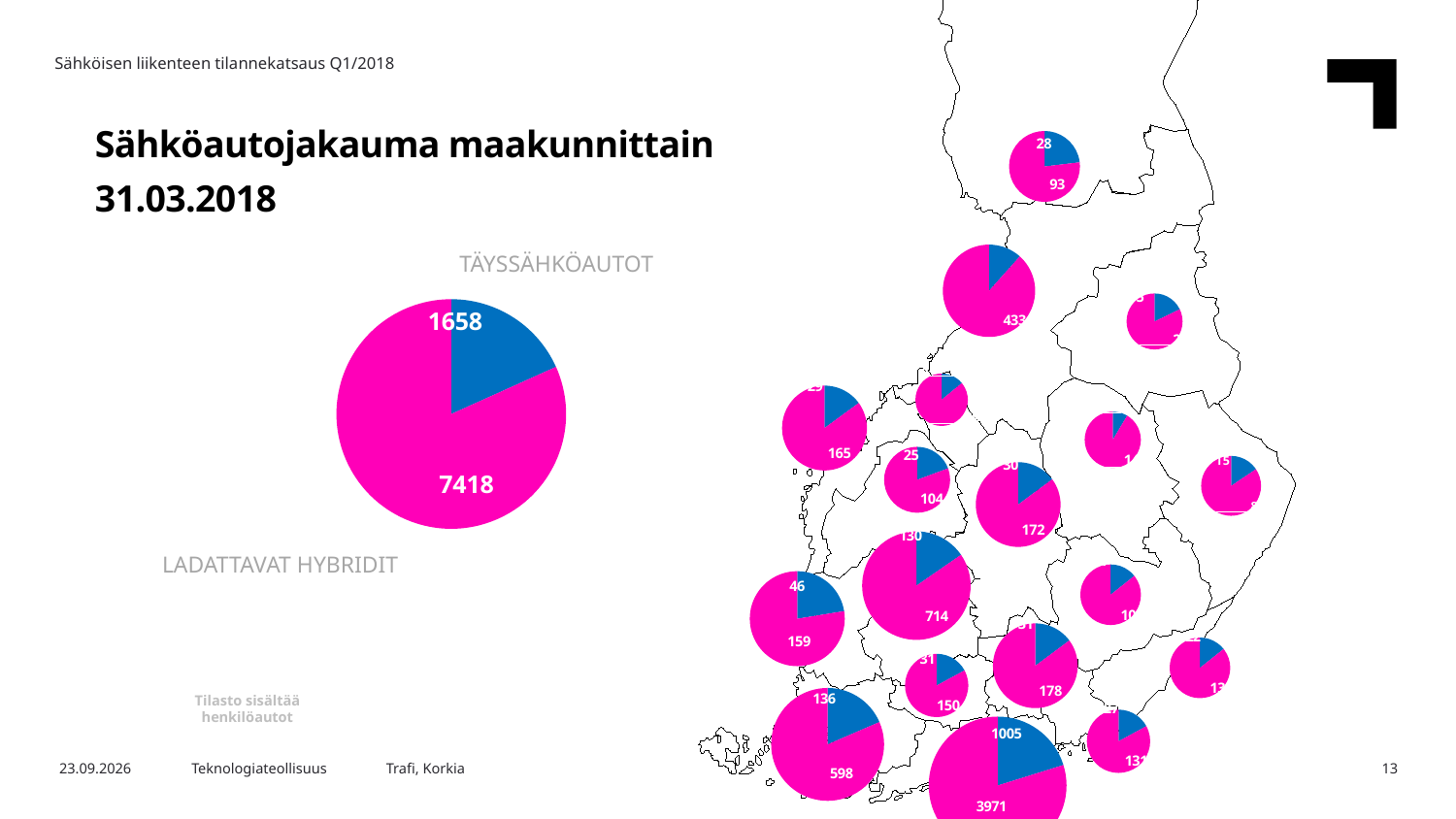
How many slices does the large pie chart on the left have? 2 In the large pie chart on the left, what is the value for TÄYSSÄHKÖAUTOT? 1658 In the large pie chart on the left, what is the value for LADATTAVAT HYBRIDIT? 7418 In the large pie chart on the left, what colour is the TÄYSSÄHKÖAUTOT slice? Blue On the map on the right, what are the two values shown in the largest pie (at the bottom)? 1005 and 3971 In the large pie chart on the left, is the value for TÄYSSÄHKÖAUTOT greater or less than 2000? less What is the title of the slide containing the pie charts? Sähköautojakauma maakunnittain 31.03.2018 In the large pie chart on the left, which category has the larger value? LADATTAVAT HYBRIDIT In the large pie chart on the left, which category has the smaller value? TÄYSSÄHKÖAUTOT In the large pie chart on the left, what is the difference between the LADATTAVAT HYBRIDIT value and the TÄYSSÄHKÖAUTOT value? 5760 In the large pie chart on the left, what is the total of the two slices? 9076 What kind of chart is the large chart on the left of the slide? Pie chart